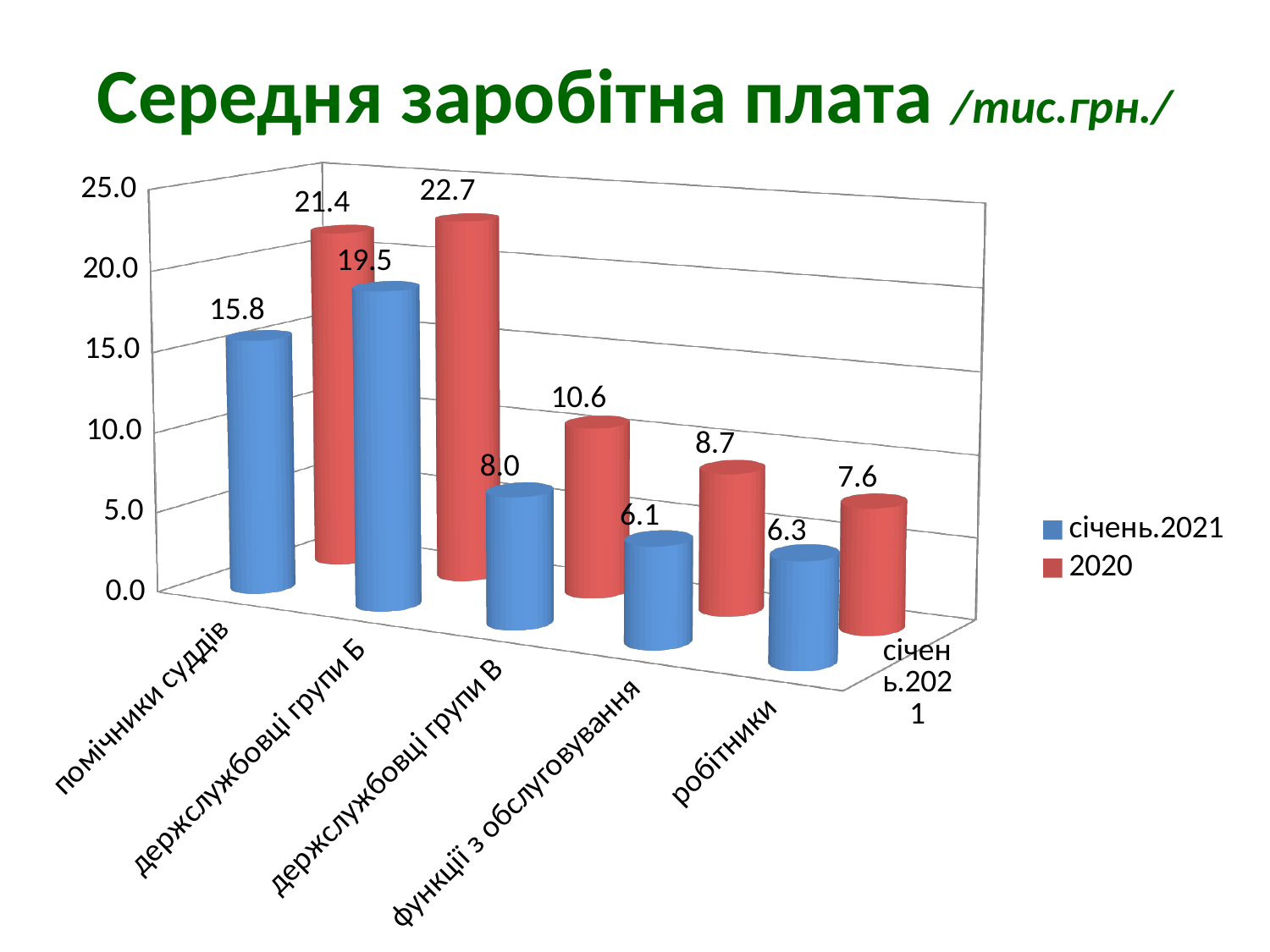
What is the difference between the 2020 and січень.2021 values for помічники суддів? 5.6 What kind of chart is shown on the slide? bar chart How many series does the legend list? 2 What is the value for держслужбовці групи Б in the 2020 series? 22.7 What is the unit given in the chart title? тис.грн. How many categories are shown on the x axis? 5 What is the value for функції з обслуговування in січень.2021? 6.1 What is the value for робітники in the 2020 series? 7.6 Which category has the highest value in the 2020 series? держслужбовці групи Б Which category has the lowest value in the січень.2021 series? функції з обслуговування What is the average salary for помічники суддів in січень.2021? 15.8 Which is larger for держслужбовці групи В: the 2020 value or the січень.2021 value? 2020